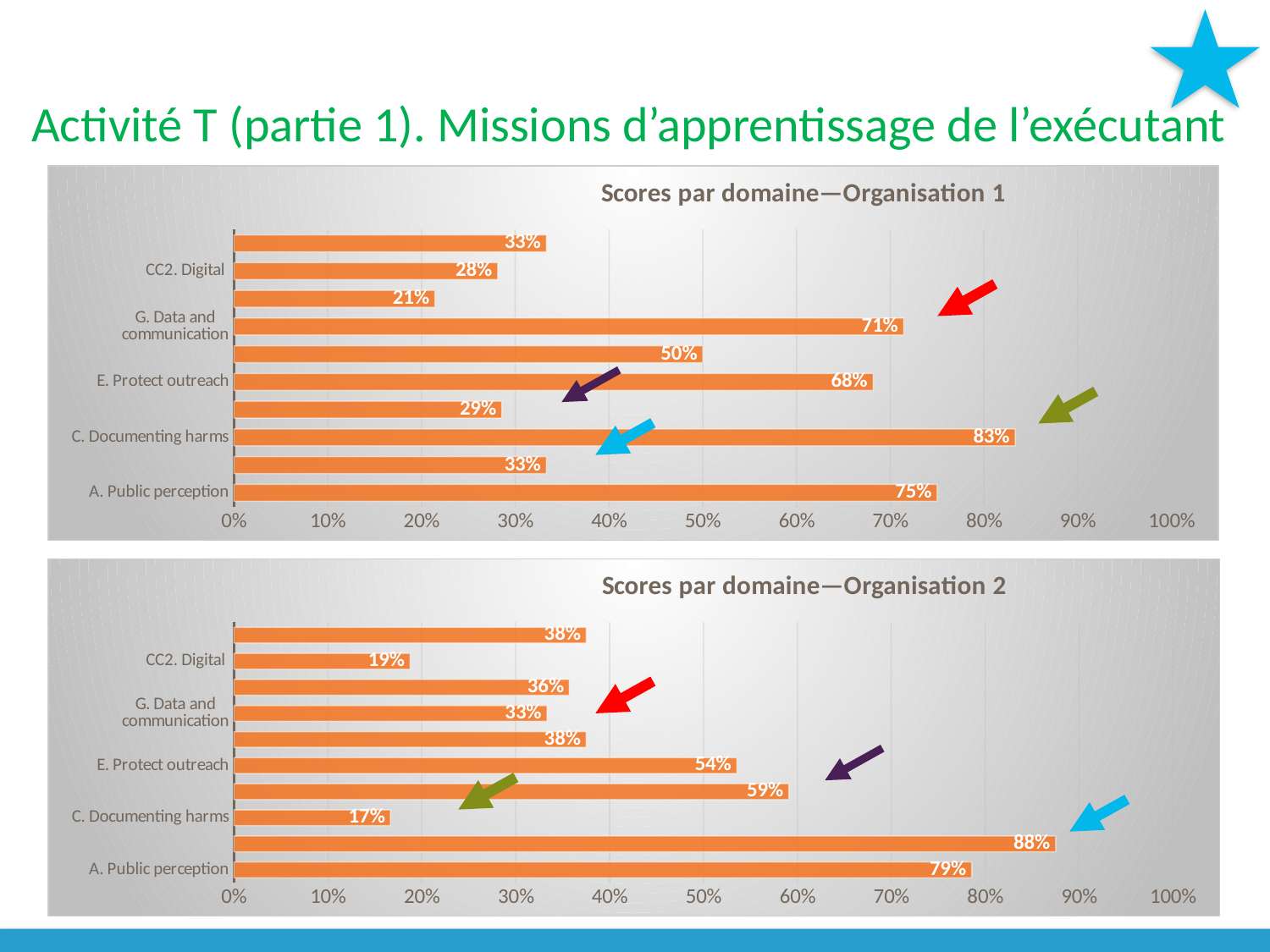
In the 'Scores par domaine—Organisation 1' chart, what is the value for C. Documenting harms? 83% In the 'Scores par domaine—Organisation 2' chart, which labelled category has the lowest value? C. Documenting harms In the 'Scores par domaine—Organisation 1' chart, what is the value for A. Public perception? 75% In the 'Scores par domaine—Organisation 1' chart, which labelled category has the highest value? C. Documenting harms In the 'Scores par domaine—Organisation 2' chart, what is the value for E. Protect outreach? 54% How many bars are plotted in the 'Scores par domaine—Organisation 1' chart? 10 In the 'Scores par domaine—Organisation 2' chart, is the value for C. Documenting harms greater or less than 20%? less In the 'Scores par domaine—Organisation 2' chart, which is larger: the value for G. Data and communication or the value for CC2. Digital? G. Data and communication In the 'Scores par domaine—Organisation 1' chart, what is the difference between the values for C. Documenting harms and E. Protect outreach? 15% In the 'Scores par domaine—Organisation 2' chart, what is the value for A. Public perception? 79% What kind of chart is 'Scores par domaine—Organisation 2'? Bar chart In the 'Scores par domaine—Organisation 1' chart, what is the value for CC2. Digital? 28%